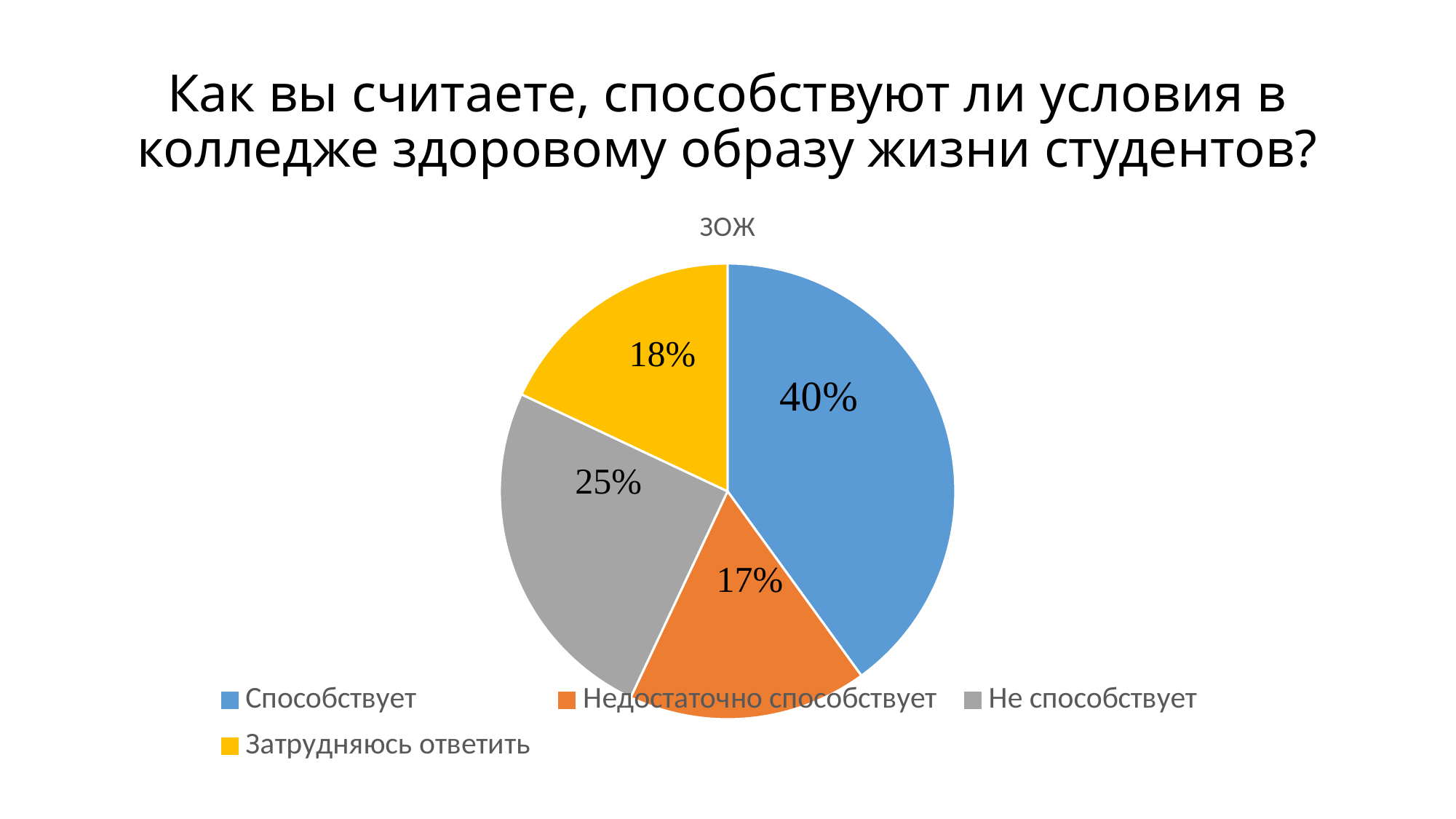
Which category has the largest slice of the pie? Способствует What share of the pie is labelled for 'Не способствует'? 25% Which category has the smallest slice of the pie? Недостаточно способствует Which is larger, the slice for 'Не способствует' or the slice for 'Затрудняюсь ответить'? Не способствует What type of chart is shown on the slide? pie chart What share of the pie is labelled for 'Недостаточно способствует'? 17% What share of the pie is labelled for 'Затрудняюсь ответить'? 18% What is the difference in percentage points between 'Способствует' and 'Не способствует'? 15% What is the chart title shown above the pie? ЗОЖ How many categories does the pie chart have? 4 What colour is the slice for 'Затрудняюсь ответить'? yellow